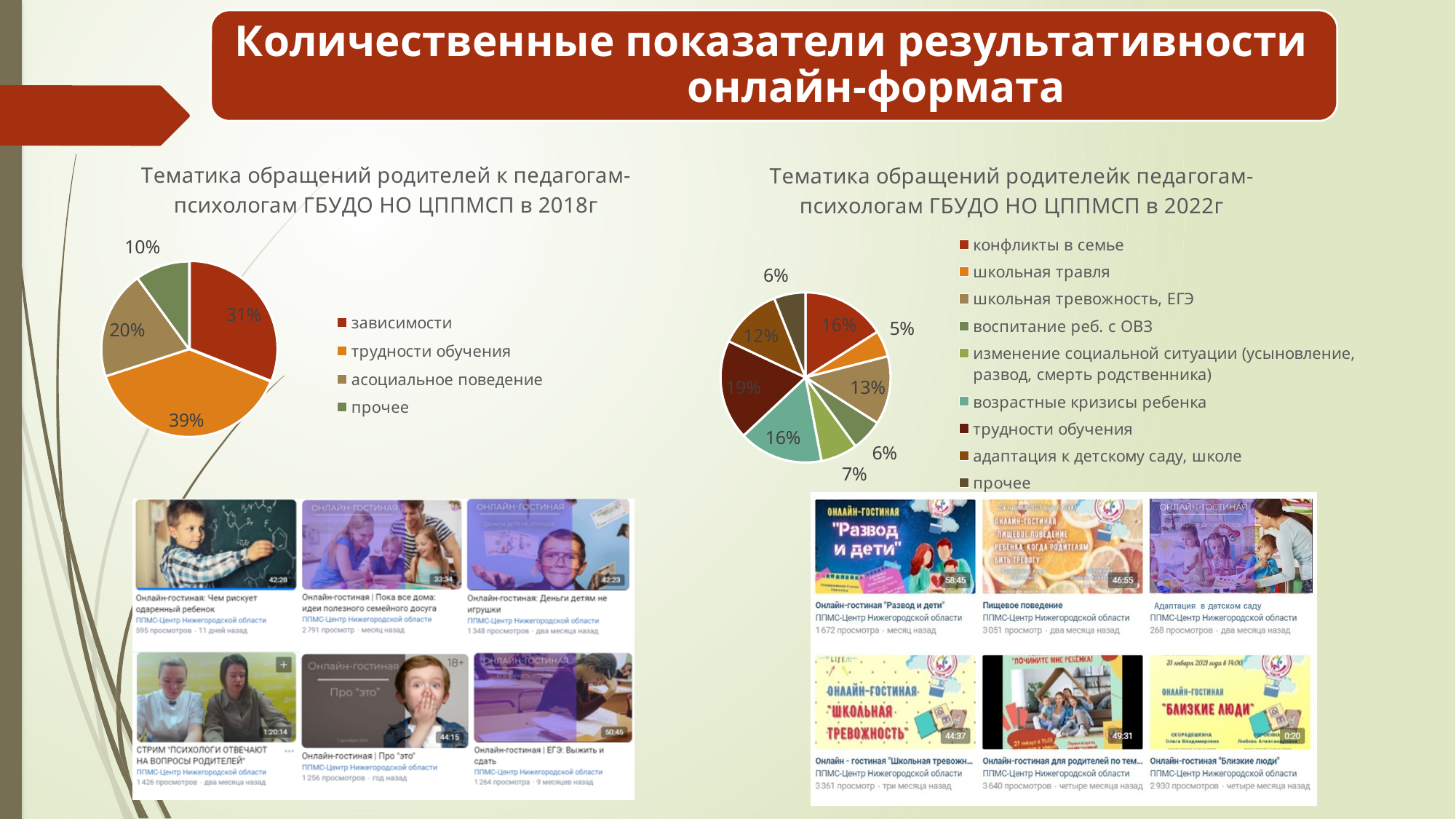
How many categories does the legend of the 2018 pie chart list? 4 In the 2018 pie chart, which category has the smallest share? прочее In the 2022 pie chart, which is larger: 'школьная тревожность, ЕГЭ' or 'адаптация к детскому саду, школе'? школьная тревожность, ЕГЭ What type of chart is used for the 2022 data on the right of the slide? pie chart In the 2022 pie chart, which category has the largest share? трудности обучения How many categories does the legend of the 2022 pie chart list? 9 In the 2022 pie chart, what share is labelled for 'школьная травля'? 5% In the 2018 pie chart, what share of parents' requests was for 'трудности обучения'? 39% In the 2018 pie chart, which category has the largest share? трудности обучения In the 2022 pie chart, what share is labelled for 'трудности обучения'? 19% In the 2018 pie chart, what share is labelled for 'зависимости'? 31% In the 2018 pie chart, what is the difference between the shares for 'трудности обучения' and 'асоциальное поведение'? 19 percentage points